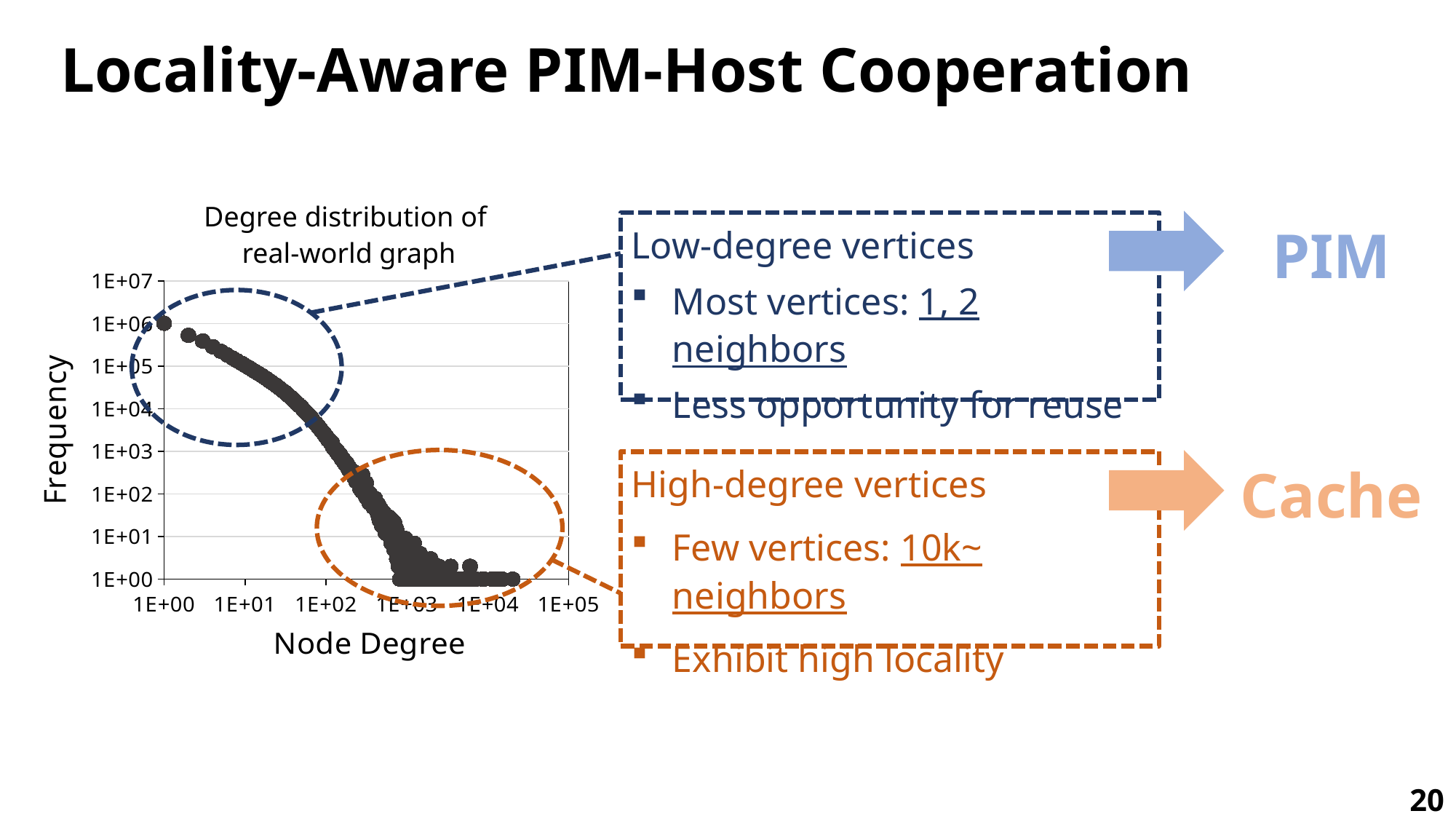
What is the lowest frequency value reached by the plotted points? 1E+00 Is the frequency at node degree 1E+00 greater or less than 1E+05? greater Is the frequency at node degree 1E+02 greater or less than 1E+05? less As node degree increases along the x axis, does frequency rise or fall? fall At which node degree is the frequency highest? 1E+00 What is the label of the chart's x axis? Node Degree What kind of chart is shown on the slide? scatter chart Is the frequency at node degree 1E+01 greater or less than 1E+04? greater What is the title of the chart? Degree distribution of real-world graph